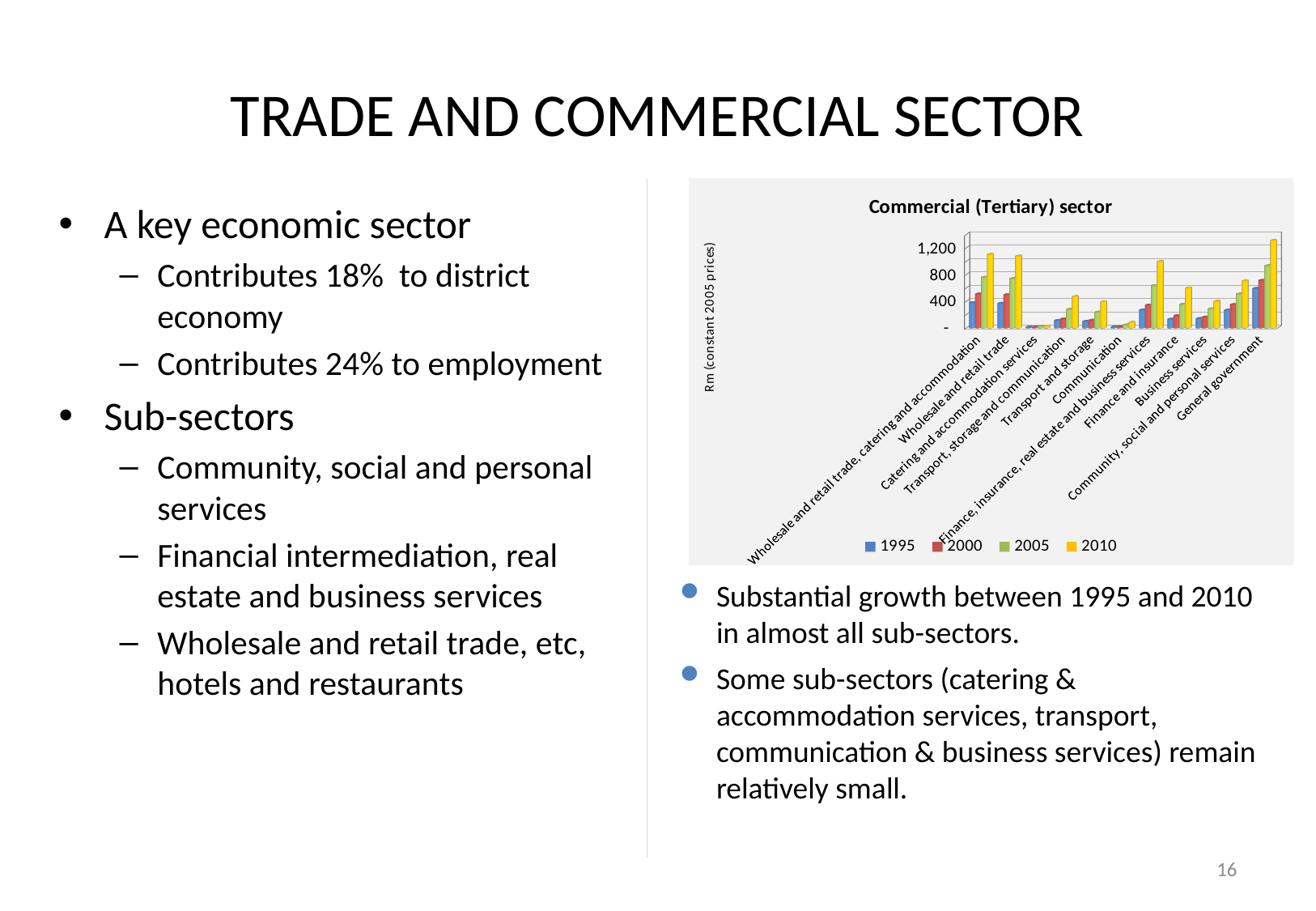
Is the 2010 value for Communication greater or less than 400? less For General government, do the values rise or fall from 1995 to 2010? rise What is the title of the chart on the slide? Commercial (Tertiary) sector For General government, which is larger: the 1995 value or the 2010 value? 2010 Is the 2010 value for Wholesale and retail trade greater or less than 800? greater Is the 2010 value for Catering and accommodation services greater or less than 400? less Which category has the highest 2010 value in the chart? General government What kind of chart is shown on the slide? Bar chart How many series does the chart's legend list? 4 Which years are listed in the chart's legend? 1995, 2000, 2005, 2010 How many sub-sector categories are shown along the x axis of the chart? 11